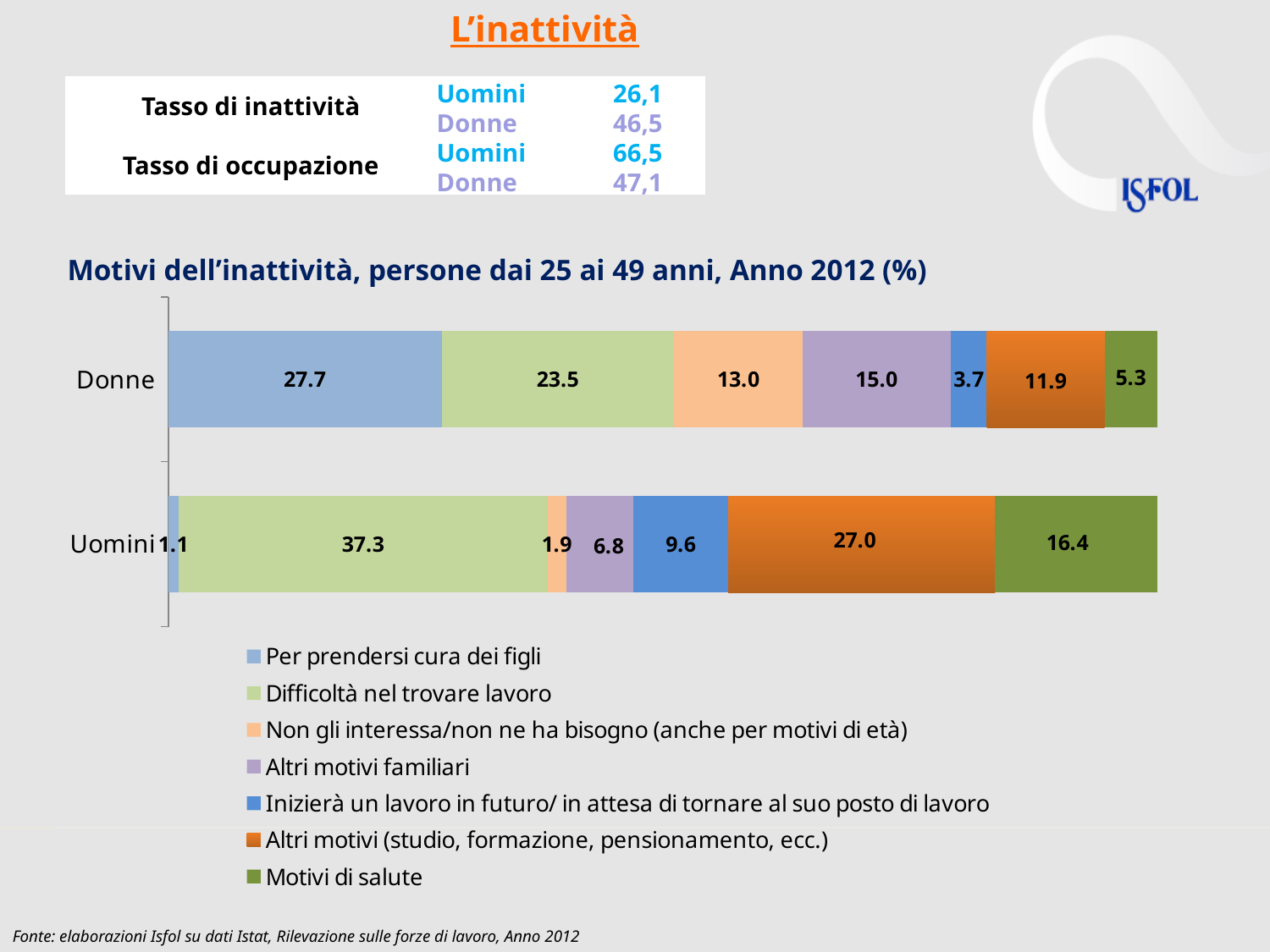
What is the value for 'Per prendersi cura dei figli' in the Donne bar? 27.7 Which reason has the smallest segment in the Uomini bar? Per prendersi cura dei figli Which reason has the largest segment in the Donne bar? Per prendersi cura dei figli What is the value for 'Motivi di salute' in the Uomini bar? 16.4 What is the value for 'Altri motivi familiari' in the Donne bar? 15.0 What is the difference between the Uomini and Donne values for 'Difficoltà nel trovare lavoro'? 13.8 What kind of chart is shown on the slide? Stacked bar chart What is the value for 'Difficoltà nel trovare lavoro' in the Uomini bar? 37.3 How many categories (bars) are shown in the chart? 2 What is the title of the chart? Motivi dell'inattività, persone dai 25 ai 49 anni, Anno 2012 (%) For 'Altri motivi (studio, formazione, pensionamento, ecc.)', which group has the larger value, Uomini or Donne? Uomini How many series does the legend list? 7